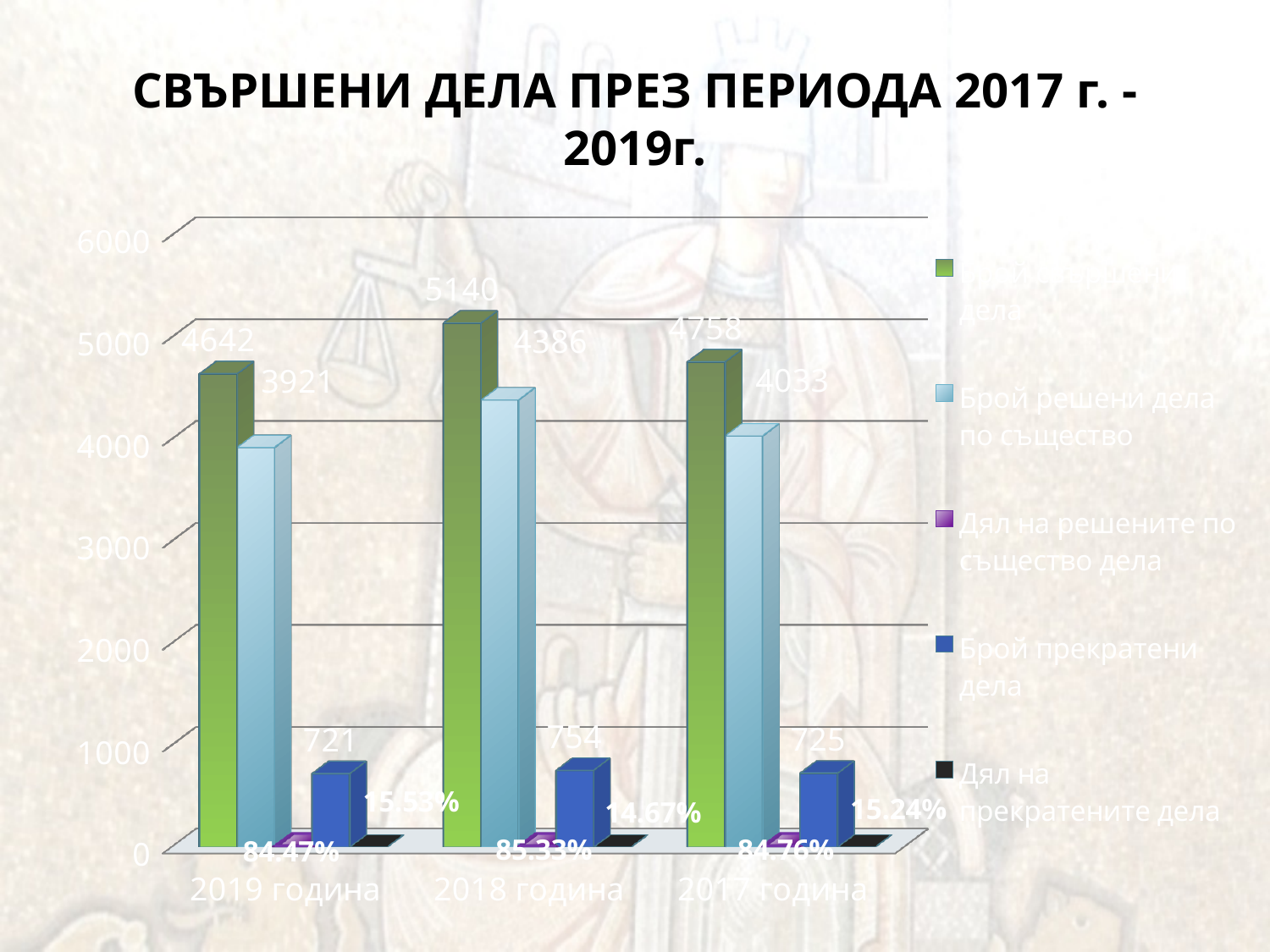
How many series does the legend list? 5 What is the value of 'Дял на прекратените дела' for 2019 година? 15.53% Which year has the highest value for the green series (the tallest bars)? 2018 година What type of chart is shown on the slide? bar chart What is the title of the chart? СВЪРШЕНИ ДЕЛА ПРЕЗ ПЕРИОДА 2017 г. - 2019г. What is the difference between the green series values for 2018 година and 2019 година? 498 What is the value of 'Брой прекратени дела' for 2017 година? 725 Which year has the lowest value for 'Брой прекратени дела'? 2019 година How many year categories are shown on the x axis? 3 Which is larger: 'Брой решени дела по същество' for 2017 година or for 2019 година? 2017 година What is the value of 'Брой решени дела по същество' for 2018 година? 4386 What is the value of 'Дял на решените по същество дела' for 2018 година? 85.33%